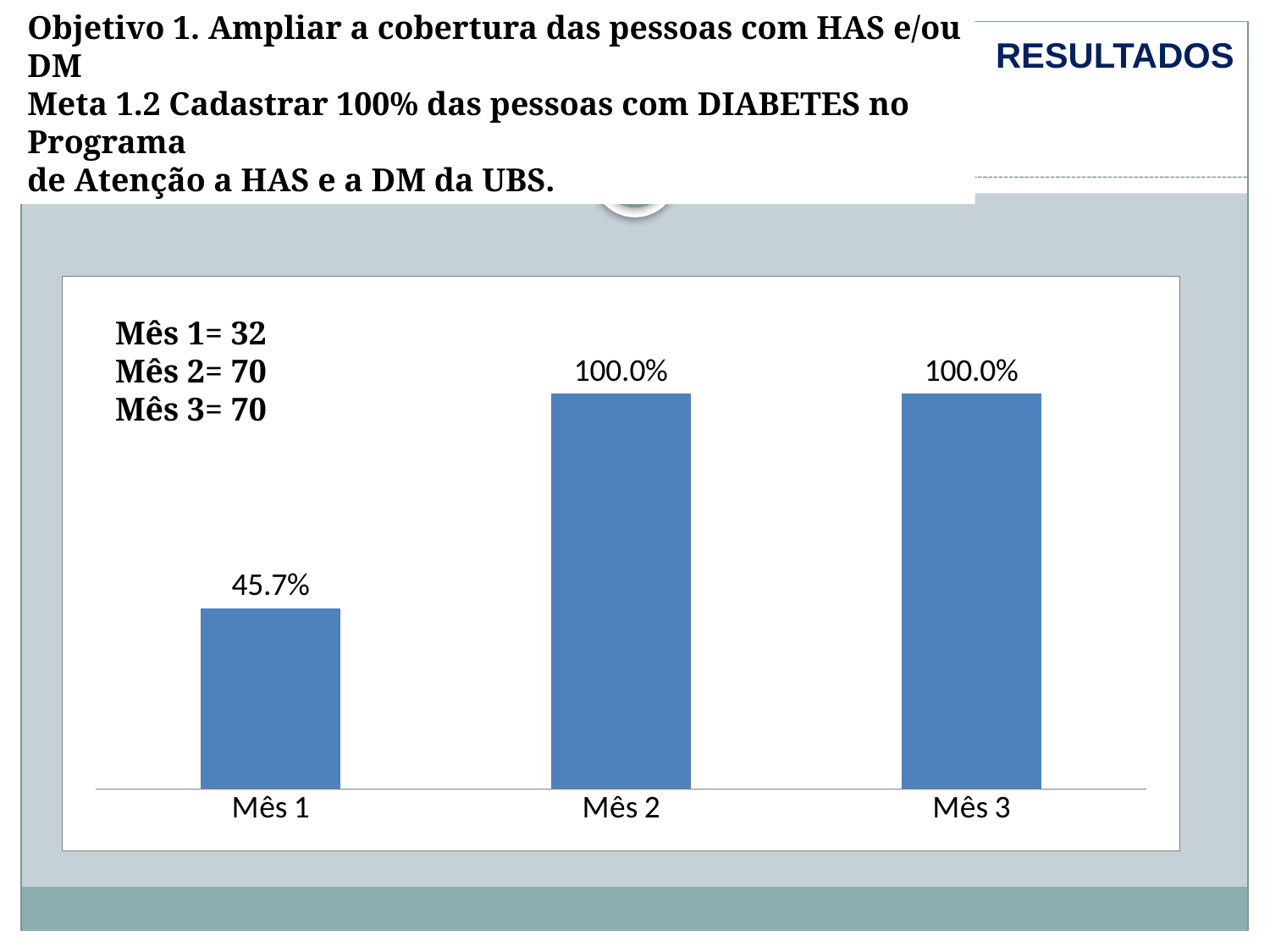
What is the value for Mês 2? 100.0% According to the text inside the chart area, what is the count for Mês 1? 32 What is the value for Mês 1? 45.7% Which category has the lowest value? Mês 1 What is the value for Mês 3? 100.0% According to the text inside the chart area, what is the count for Mês 3? 70 Do the values rise or fall from Mês 1 to Mês 2? rise What is the difference between the values for Mês 2 and Mês 1? 54.3% How many categories are shown on the x axis? 3 Which is larger, the value for Mês 1 or the value for Mês 3? Mês 3 What kind of chart is shown on the slide? bar chart